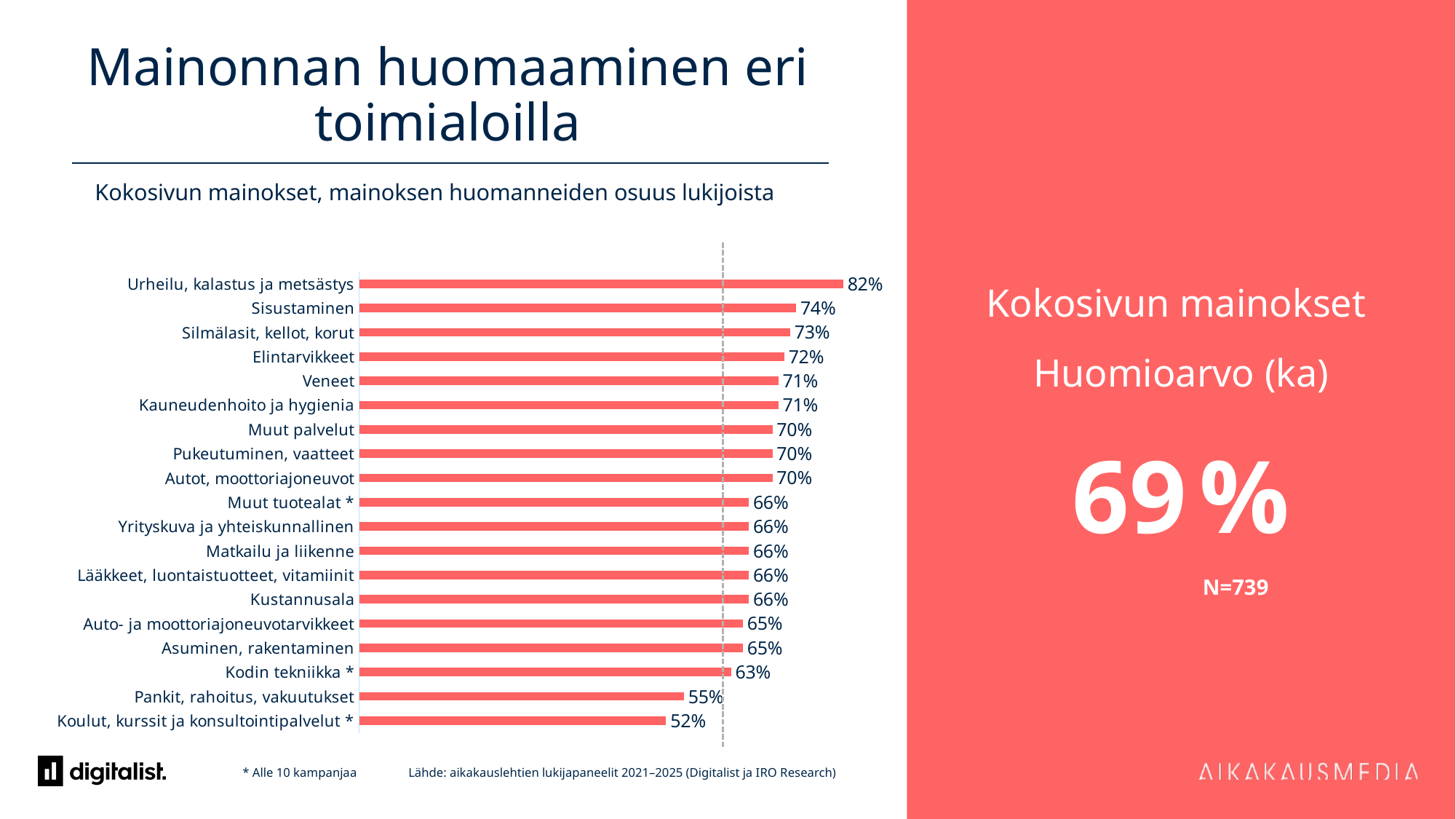
What is the sample size (N) shown on the slide? N=739 What kind of chart is shown on the slide? Bar chart What is the value for Urheilu, kalastus ja metsästys? 82% What is the average (ka) Huomioarvo for Kokosivun mainokset shown on the right panel? 69 % What is the value for Kodin tekniikka *? 63% What is the difference between the values for Sisustaminen and Elintarvikkeet? 2% Which is larger, the value for Veneet or the value for Kustannusala? Veneet What is the difference between the values for Urheilu, kalastus ja metsästys and Koulut, kurssit ja konsultointipalvelut *? 30% How many categories are shown in the chart? 19 What is the value for Pankit, rahoitus, vakuutukset? 55% Which category has the highest value? Urheilu, kalastus ja metsästys Which category has the lowest value? Koulut, kurssit ja konsultointipalvelut *